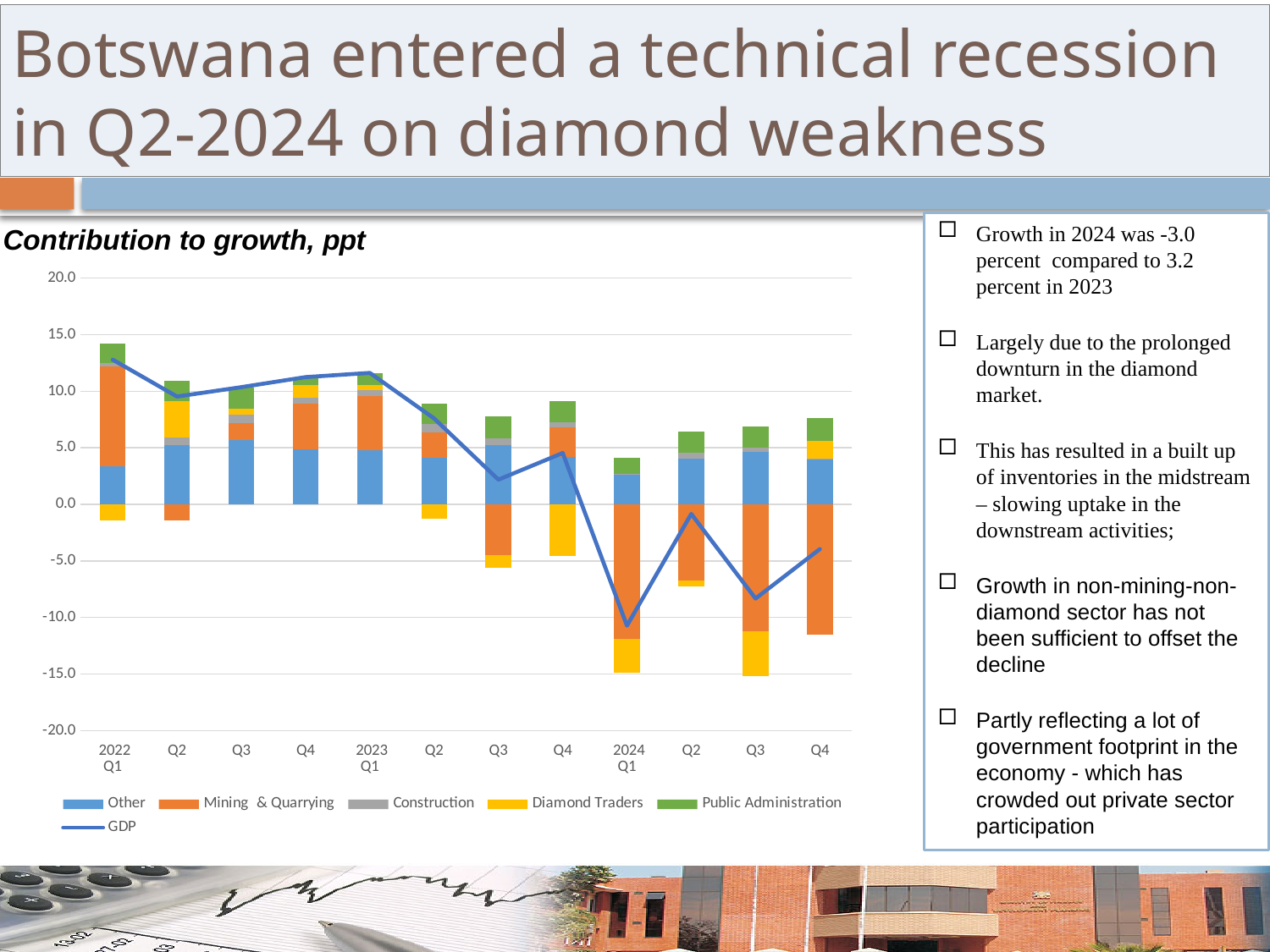
Is the GDP value for 2023 Q3 greater or less than 5.0? less Is the GDP value for 2024 Q1 greater or less than -5.0? less What is the title of the chart? Contribution to growth, ppt Is the GDP value for 2022 Q1 greater or less than 10.0? greater How many series does the chart legend list? 6 In which quarter does the GDP line reach its lowest point? 2024 Q1 Does the GDP line rise or fall overall from 2023 Q1 to 2024 Q1? fall How many quarters are shown on the x axis of the chart? 12 Which is larger, the Mining & Quarrying contribution in 2022 Q1 or in 2024 Q1? 2022 Q1 What kind of chart is shown on the slide? Stacked bar chart with a line Which series in the chart is plotted as a line rather than bars? GDP